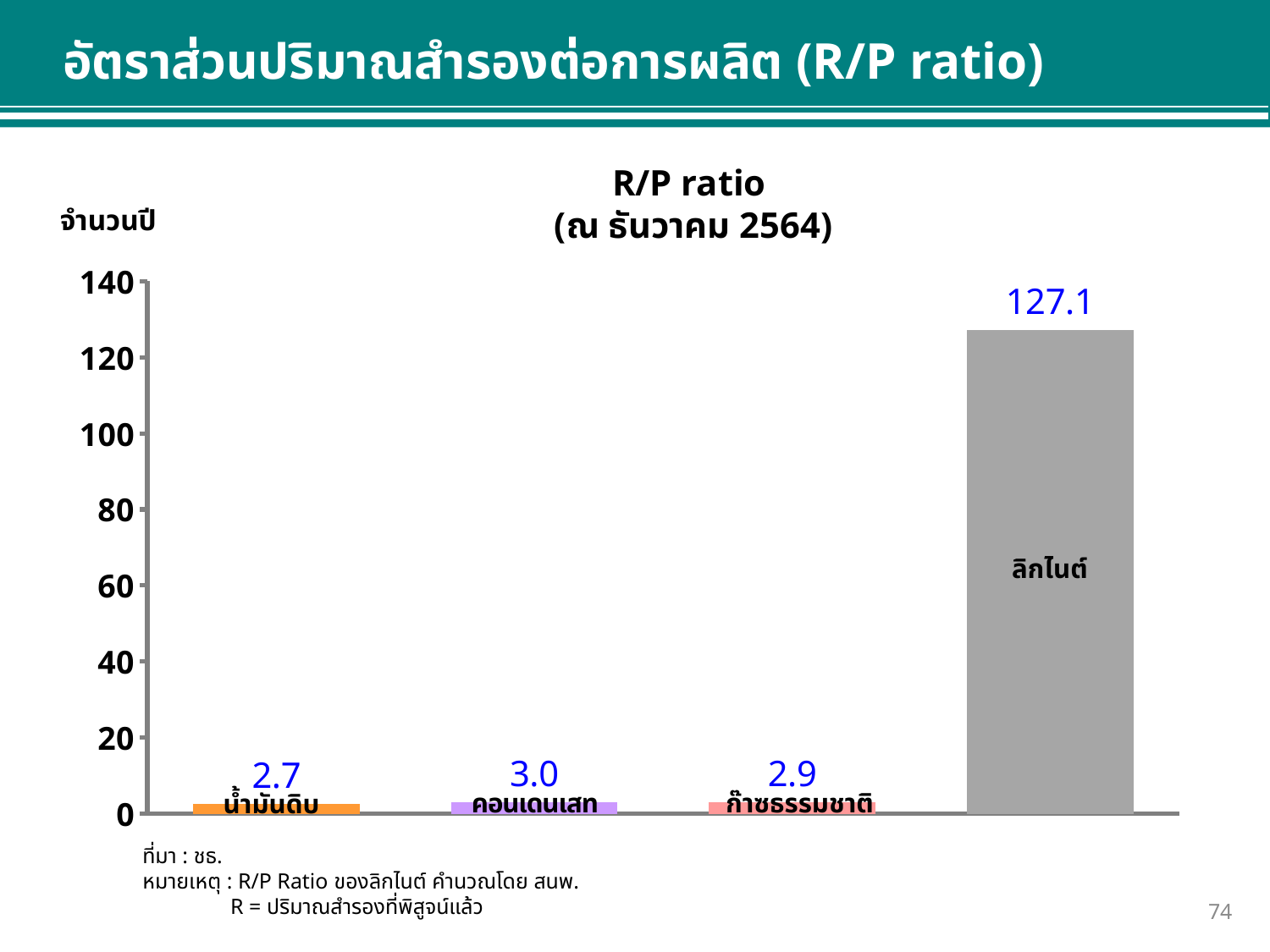
What is the R/P ratio value shown for ลิกไนต์? 127.1 What is the title of the chart? R/P ratio (ณ ธันวาคม 2564) What kind of chart is shown on the slide? Bar chart What is the R/P ratio value shown for คอนเดนเสท? 3.0 Which category has the highest R/P ratio? ลิกไนต์ Is the value for ลิกไนต์ greater or less than 120? greater What is the R/P ratio value shown for ก๊าซธรรมชาติ? 2.9 What is the difference between the R/P ratio of ลิกไนต์ and that of คอนเดนเสท? 124.1 What is the difference between the R/P ratio of คอนเดนเสท and that of น้ำมันดิบ? 0.3 What is the R/P ratio value shown for น้ำมันดิบ? 2.7 Which category has the lowest R/P ratio? น้ำมันดิบ How many categories are plotted in the chart? 4